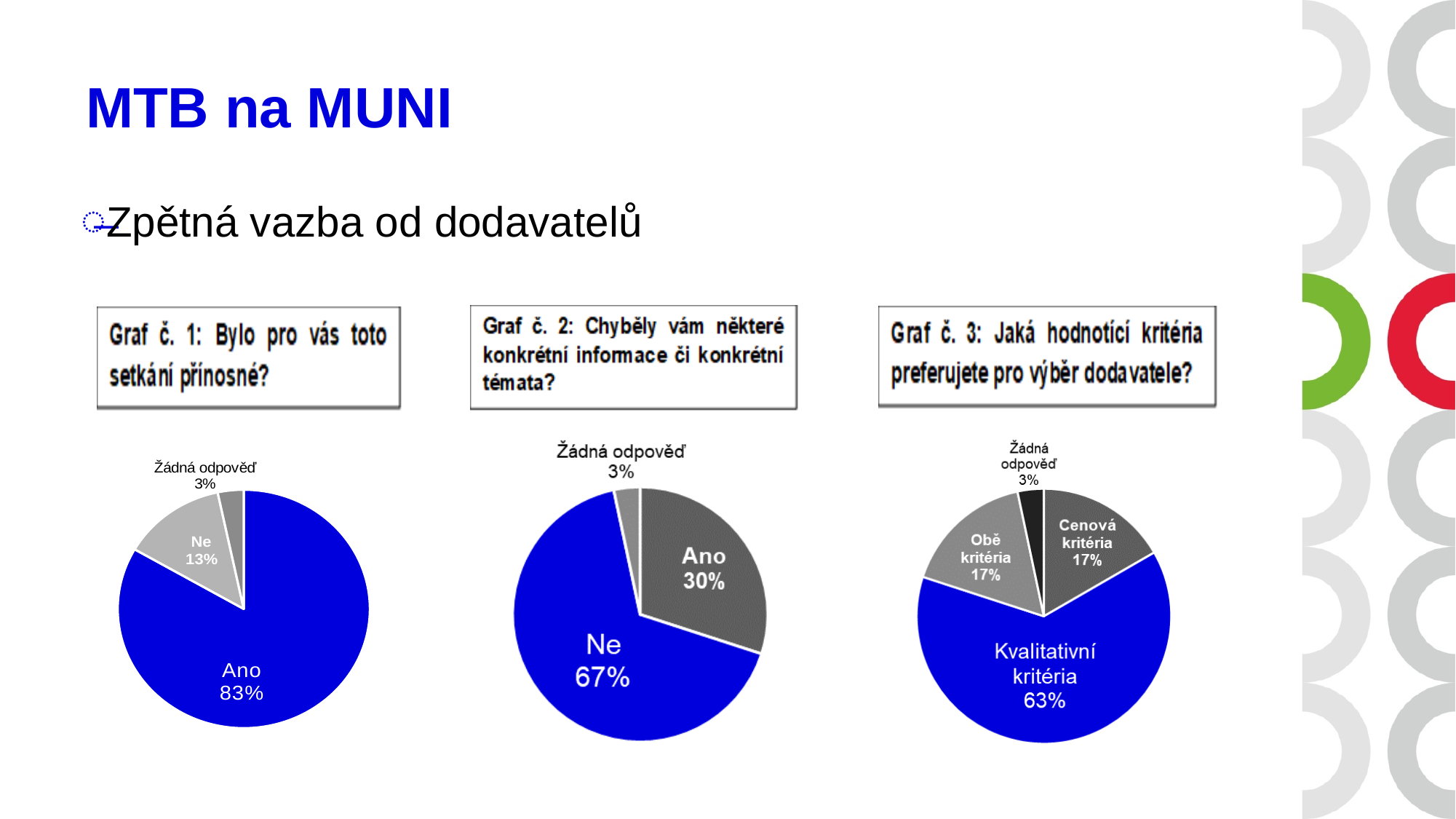
In Graf č. 3, what share of respondents chose "Cenová kritéria"? 17% In Graf č. 2, which category has the largest slice? Ne In Graf č. 1, which category has the smallest slice? Žádná odpověď In Graf č. 3, what share of respondents chose "Kvalitativní kritéria"? 63% In Graf č. 1, which is larger, the "Ano" slice or the "Ne" slice? Ano In Graf č. 1, what share of respondents answered "Ne"? 13% What kind of chart is Graf č. 1? Pie chart In Graf č. 3, how many slices does the pie chart have? 4 In Graf č. 2, what is the difference between the "Ne" and "Ano" shares? 37%